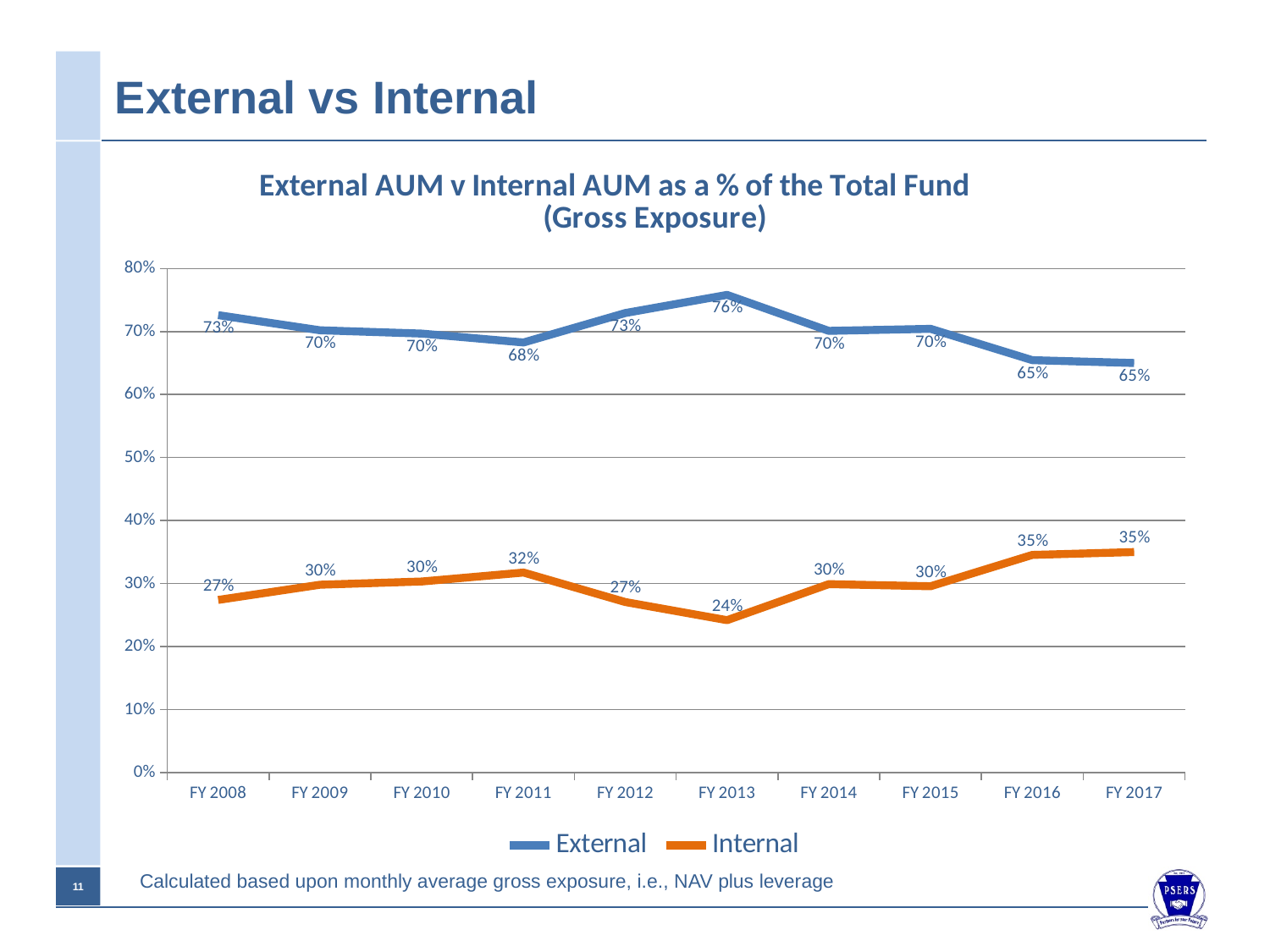
What kind of chart is shown on the slide? Line chart In which fiscal year is the Internal series at its lowest? FY 2013 What is the difference between the External and Internal values in FY 2008? 46% Which is larger, the Internal value for FY 2016 or the Internal value for FY 2013? FY 2016 How many fiscal years are shown on the x axis? 10 In which fiscal year is the External series at its highest? FY 2013 How many series does the legend list? 2 What is the Internal value for FY 2011? 32% What is the Internal value for FY 2017? 35% Is the External value for FY 2017 greater or less than 60%? greater What is the External value for FY 2013? 76% Does the External series rise or fall from FY 2015 to FY 2017? Fall